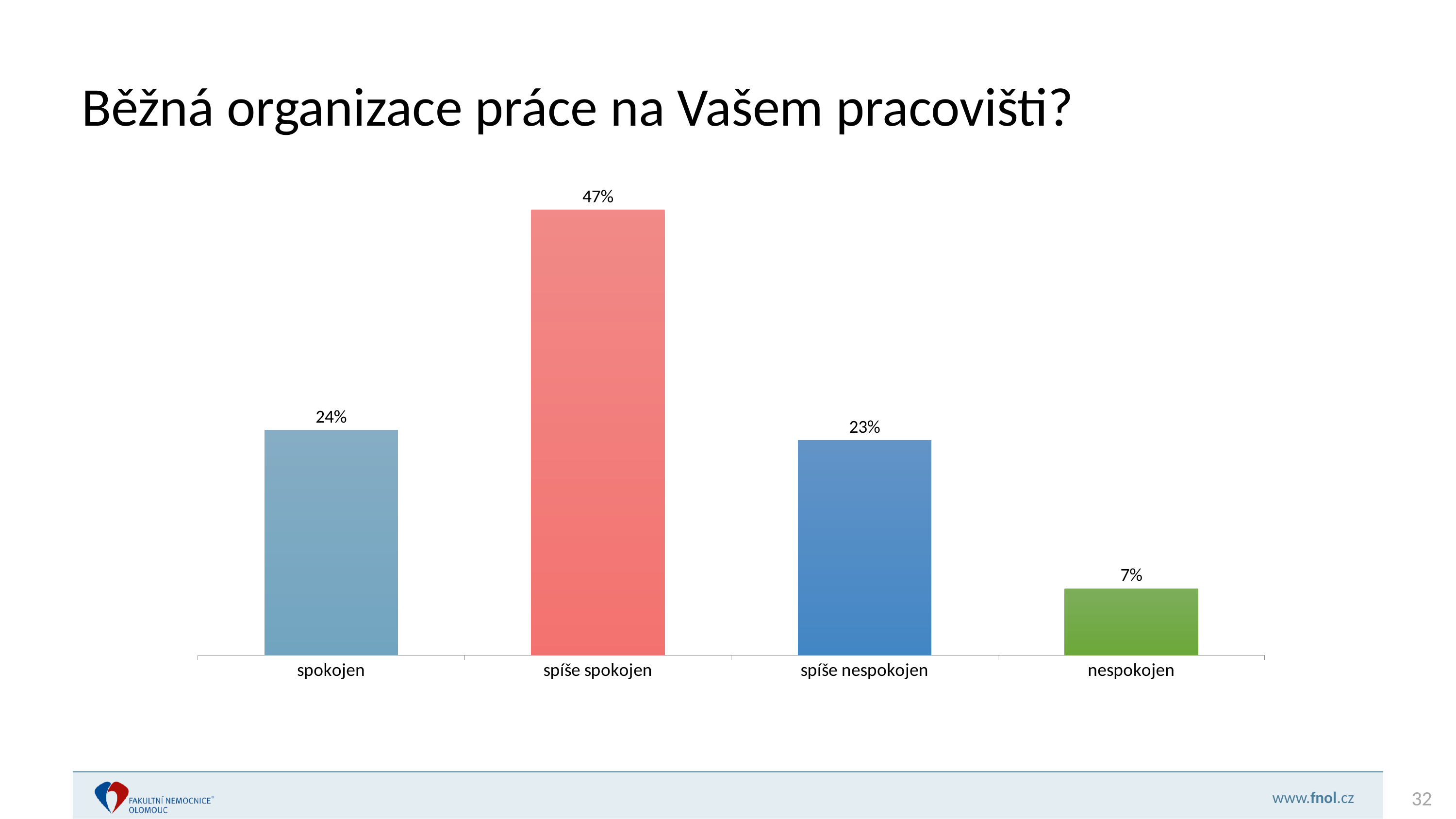
What is the value for "spokojen"? 24% What is the value for "spíše nespokojen"? 23% What is the difference between the values for "spíše spokojen" and "spokojen"? 23% Which category has the lowest value? nespokojen What kind of chart is shown on the slide? bar chart What is the title of the slide containing the chart? Běžná organizace práce na Vašem pracovišti? What is the value for "nespokojen"? 7% How many categories are shown on the x axis? 4 What is the value for "spíše spokojen"? 47% Which is larger, the value for "spokojen" or the value for "nespokojen"? spokojen Which category has the highest value? spíše spokojen What is the difference between the values for "spíše nespokojen" and "nespokojen"? 16%